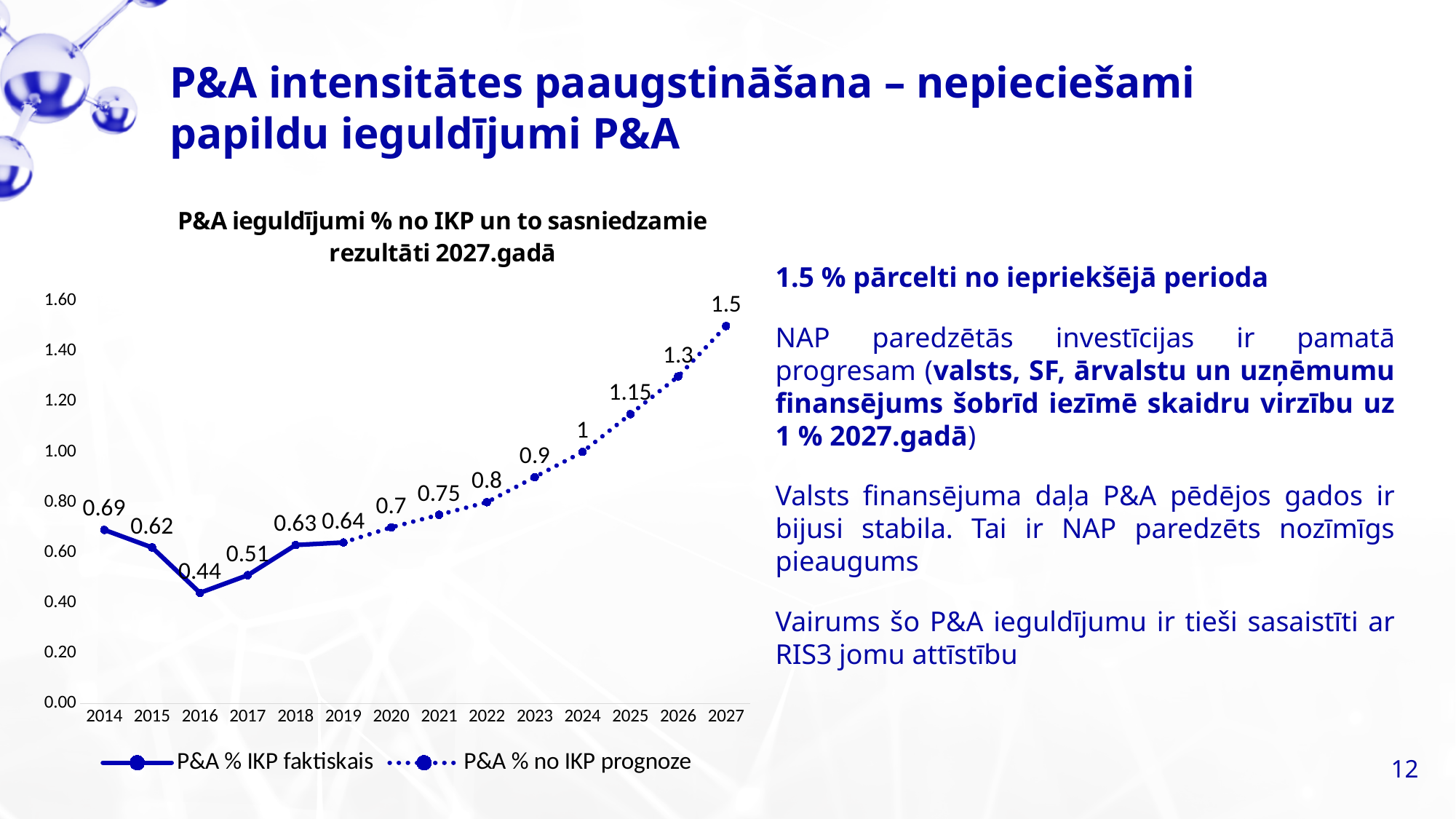
How many years are shown on the x axis of the chart? 14 Which is larger, the value for 2014 or the value for 2018? 2014 What is the value for 2023 in the chart? 0.9 How many series does the chart legend list? 2 What is the difference between the values for 2027 and 2019? 0.86 Do the values rise or fall from 2020 to 2027? rise Which year has the highest value in the chart? 2027 What is the value for 2016 in the chart? 0.44 What type of chart is shown on the slide? line chart Which year has the lowest value in the chart? 2016 What is the value for 2027 in the chart? 1.5 What is the title of the chart? P&A ieguldījumi % no IKP un to sasniedzamie rezultāti 2027.gadā